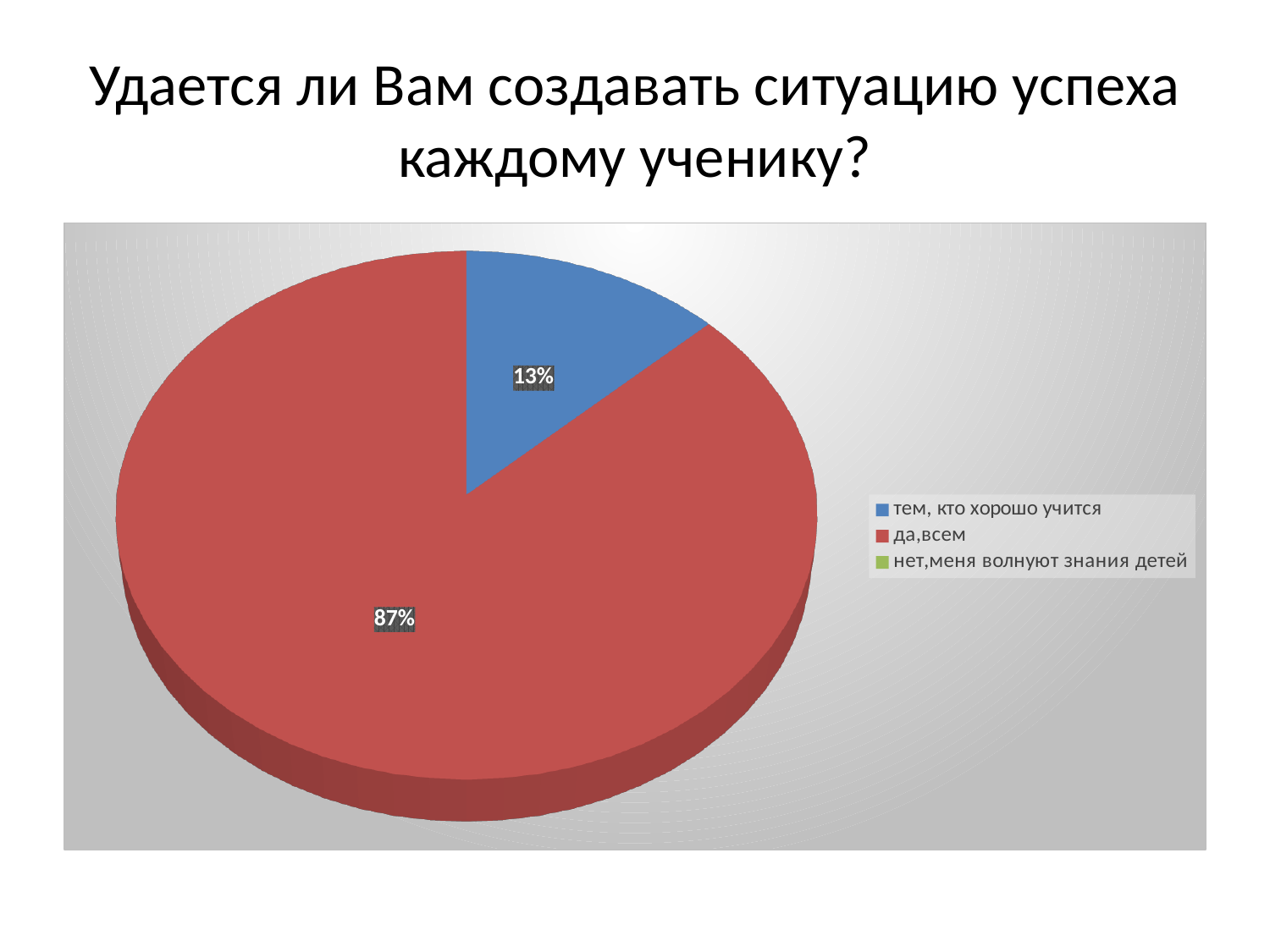
Which of the two labelled slices is larger: "да,всем" or "тем, кто хорошо учится"? да,всем What share of the pie does "тем, кто хорошо учится" take? 13% How many slices with data labels are visible in the pie? 2 Which legend entry has no visible slice in the pie? нет,меня волнуют знания детей What is the title of the slide above the chart? Удается ли Вам создавать ситуацию успеха каждому ученику? How many entries does the legend list? 3 What share of the pie does "да,всем" take? 87% Which category has the largest slice of the pie? да,всем What is the difference in percentage points between the "да,всем" slice and the "тем, кто хорошо учится" slice? 74% What kind of chart is shown on the slide? pie chart What colour is the slice for "тем, кто хорошо учится"? blue